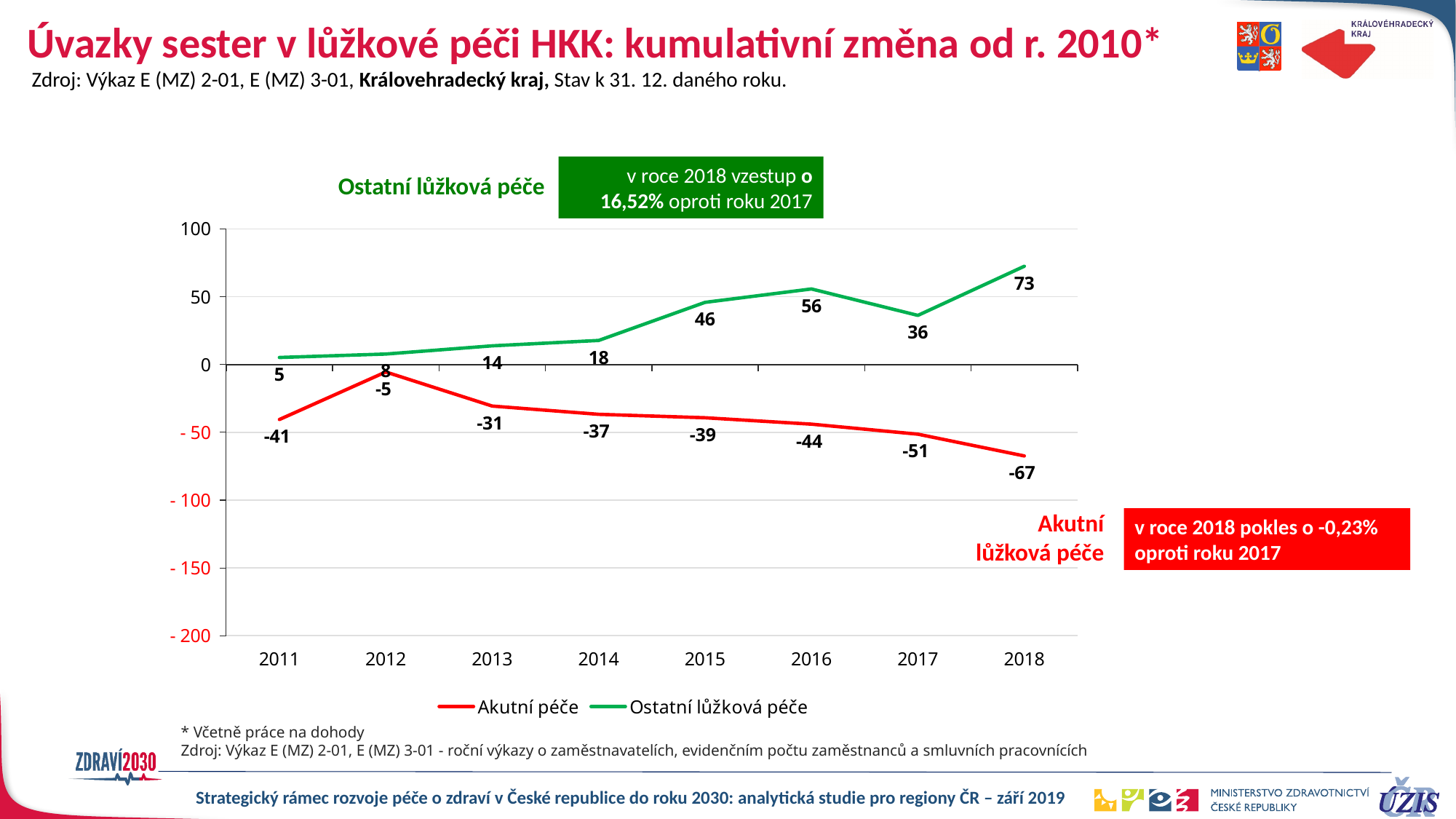
In which year does Akutní péče have its lowest value? 2018 What is the value for Ostatní lůžková péče in 2018? 73 What kind of chart is shown on the slide? line chart How many series does the legend list? 2 What is the difference between the Ostatní lůžková péče values in 2016 and 2017? 20 In which year does Ostatní lůžková péče reach its highest value? 2018 What is the value for Akutní péče in 2011? -41 What is the value for Ostatní lůžková péče in 2015? 46 Is the value for Akutní péče in 2018 greater or less than -50? less Which series has the larger value in 2012, Akutní péče or Ostatní lůžková péče? Ostatní lůžková péče How many years are shown on the x axis? 8 What is the value for Akutní péče in 2016? -44